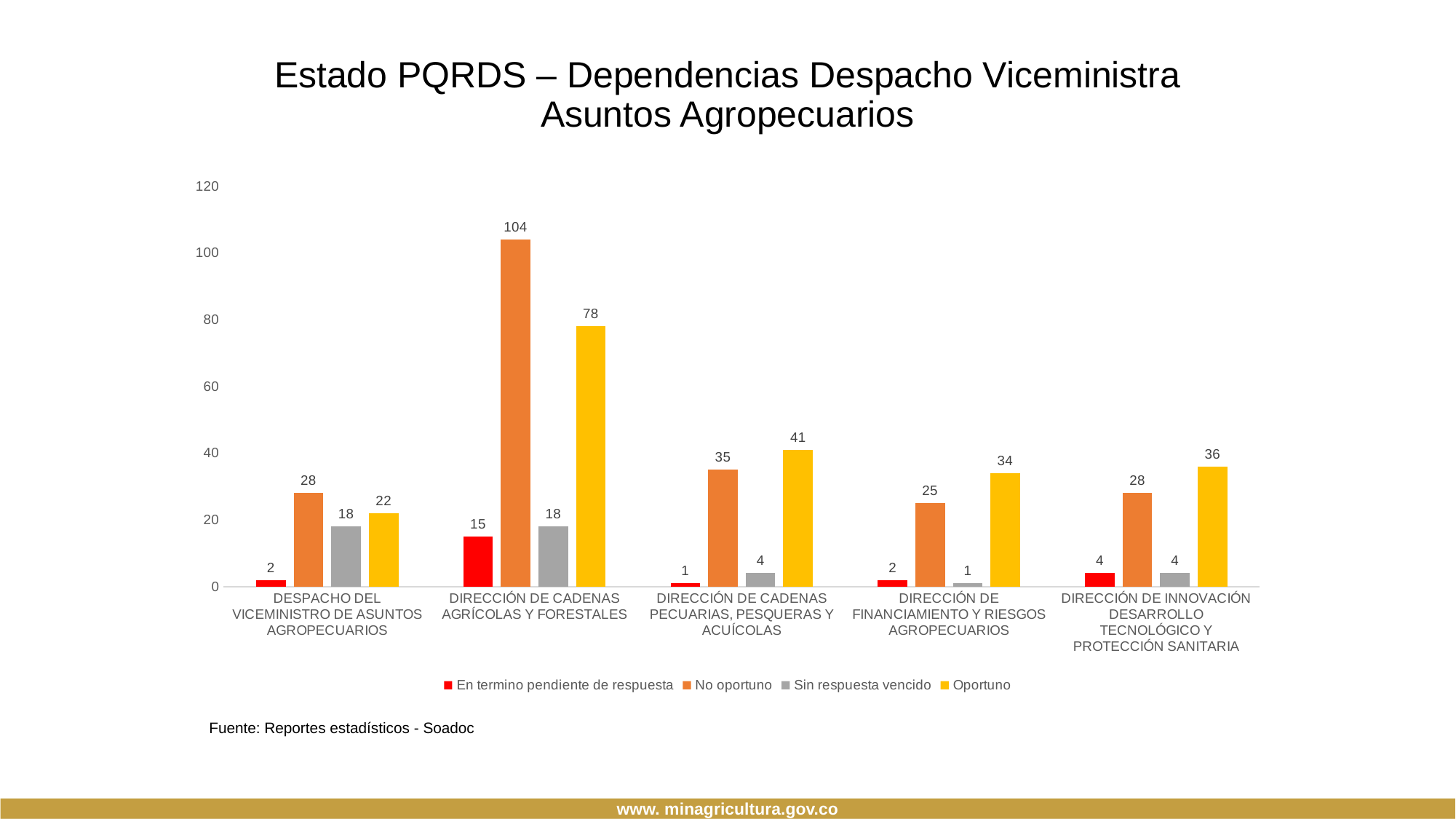
What is the source cited below the chart? Reportes estadísticos - Soadoc Which is larger for DIRECCIÓN DE INNOVACIÓN DESARROLLO TECNOLÓGICO Y PROTECCIÓN SANITARIA: "No oportuno" or "Oportuno"? Oportuno How many categories (dependencias) are shown on the x axis? 5 What is the value of "Oportuno" for DIRECCIÓN DE FINANCIAMIENTO Y RIESGOS AGROPECUARIOS? 34 What is the value of "Sin respuesta vencido" for DESPACHO DEL VICEMINISTRO DE ASUNTOS AGROPECUARIOS? 18 Is the "No oportuno" value for DIRECCIÓN DE CADENAS AGRÍCOLAS Y FORESTALES greater or less than 100? greater What is the value of "No oportuno" for DIRECCIÓN DE CADENAS AGRÍCOLAS Y FORESTALES? 104 How many series does the legend list? 4 What is the difference between the "No oportuno" and "Oportuno" values for DIRECCIÓN DE CADENAS AGRÍCOLAS Y FORESTALES? 26 What kind of chart is shown on the slide? Bar chart Which category has the highest "Oportuno" value? DIRECCIÓN DE CADENAS AGRÍCOLAS Y FORESTALES Which category has the lowest "En termino pendiente de respuesta" value? DIRECCIÓN DE CADENAS PECUARIAS, PESQUERAS Y ACUÍCOLAS